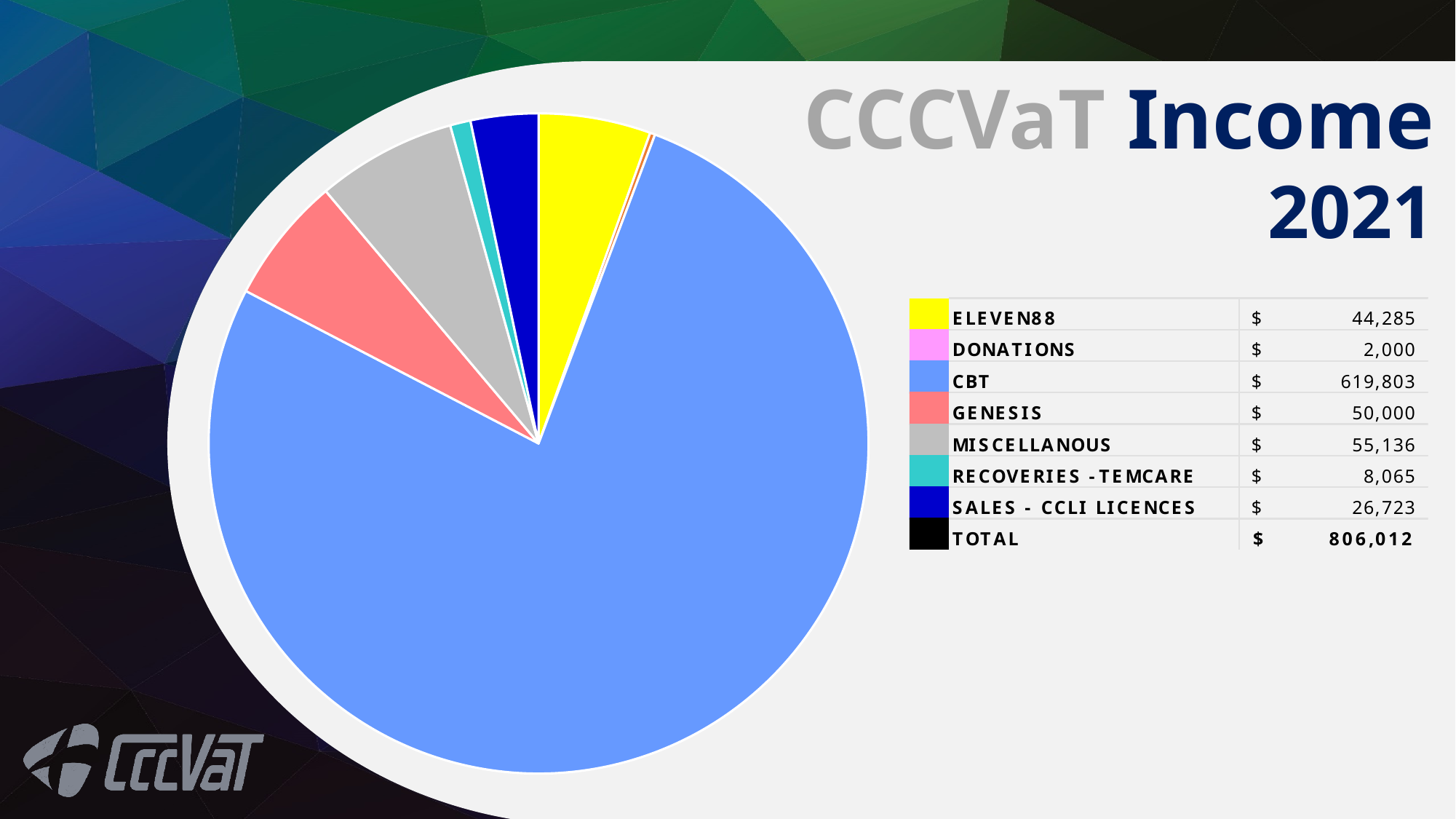
What colour represents GENESIS in the pie chart? pink/salmon Which income category has the smallest value? DONATIONS What is the income value for CBT? $ 619,803 What is the income value for ELEVEN88? $ 44,285 What is the total income shown on the slide? $ 806,012 What is the income value for RECOVERIES - TEMCARE? $ 8,065 What is the income value for SALES - CCLI LICENCES? $ 26,723 Which income category has the largest value? CBT Which is larger, GENESIS or ELEVEN88? GENESIS What kind of chart is shown on the slide? pie chart How many income categories are shown in the pie chart (excluding the total)? 7 What is the difference between the MISCELLANOUS and GENESIS values? 5,136